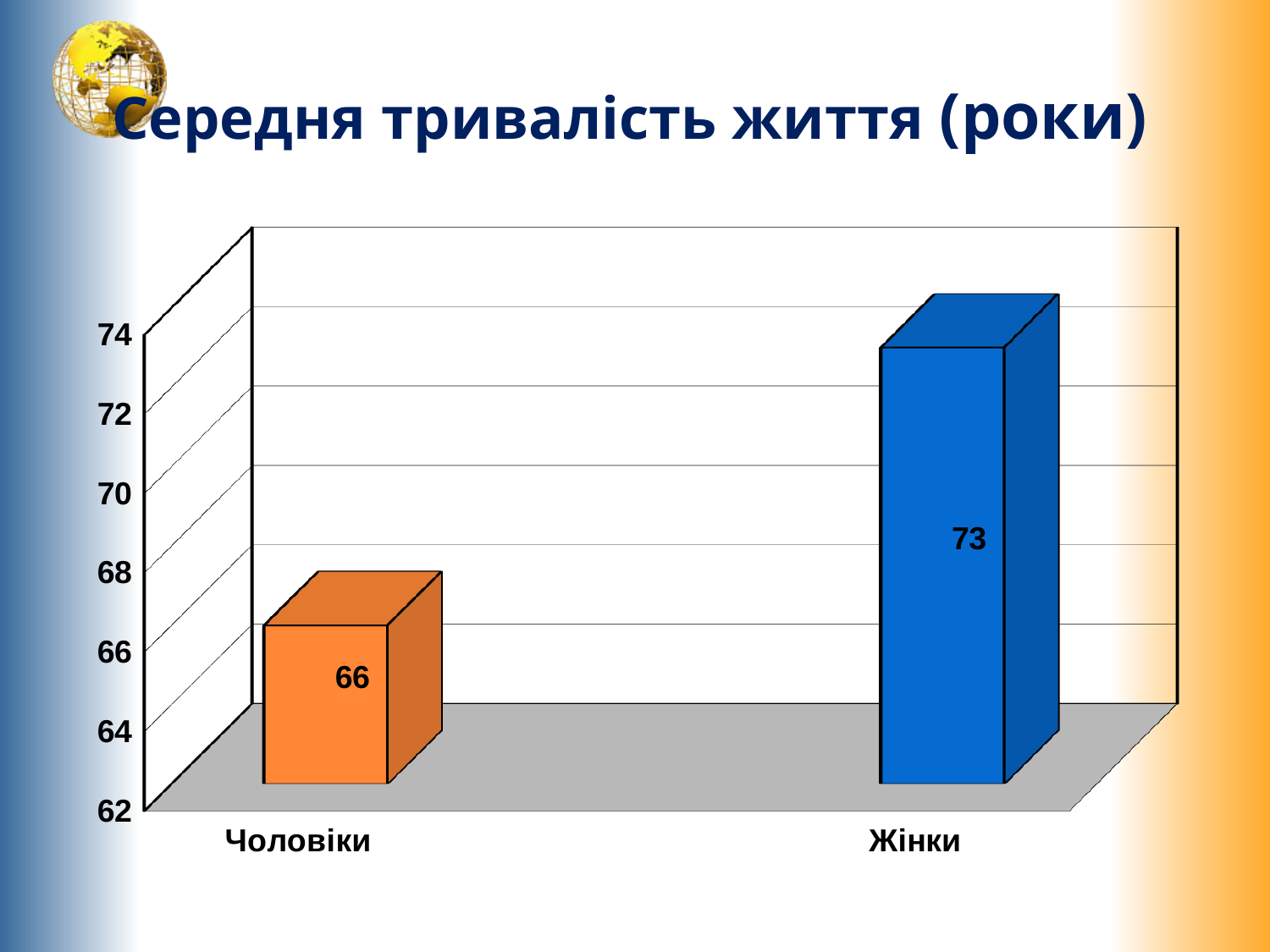
Which category has the higher value, Чоловіки or Жінки? Жінки What is the title of the slide? Середня тривалість життя (роки) Is the value for Чоловіки greater or less than 68? less How many categories are shown on the chart? 2 What is the difference between the values for Жінки and Чоловіки? 7 What is the average life expectancy value shown for Жінки? 73 Which category has the lowest value on the chart? Чоловіки What colour is the bar for Жінки? blue Is the value for Жінки greater or less than 70? greater What is the average life expectancy value shown for Чоловіки? 66 Is the value for Чоловіки larger or smaller than the value for Жінки? smaller What kind of chart is shown on the slide? bar chart